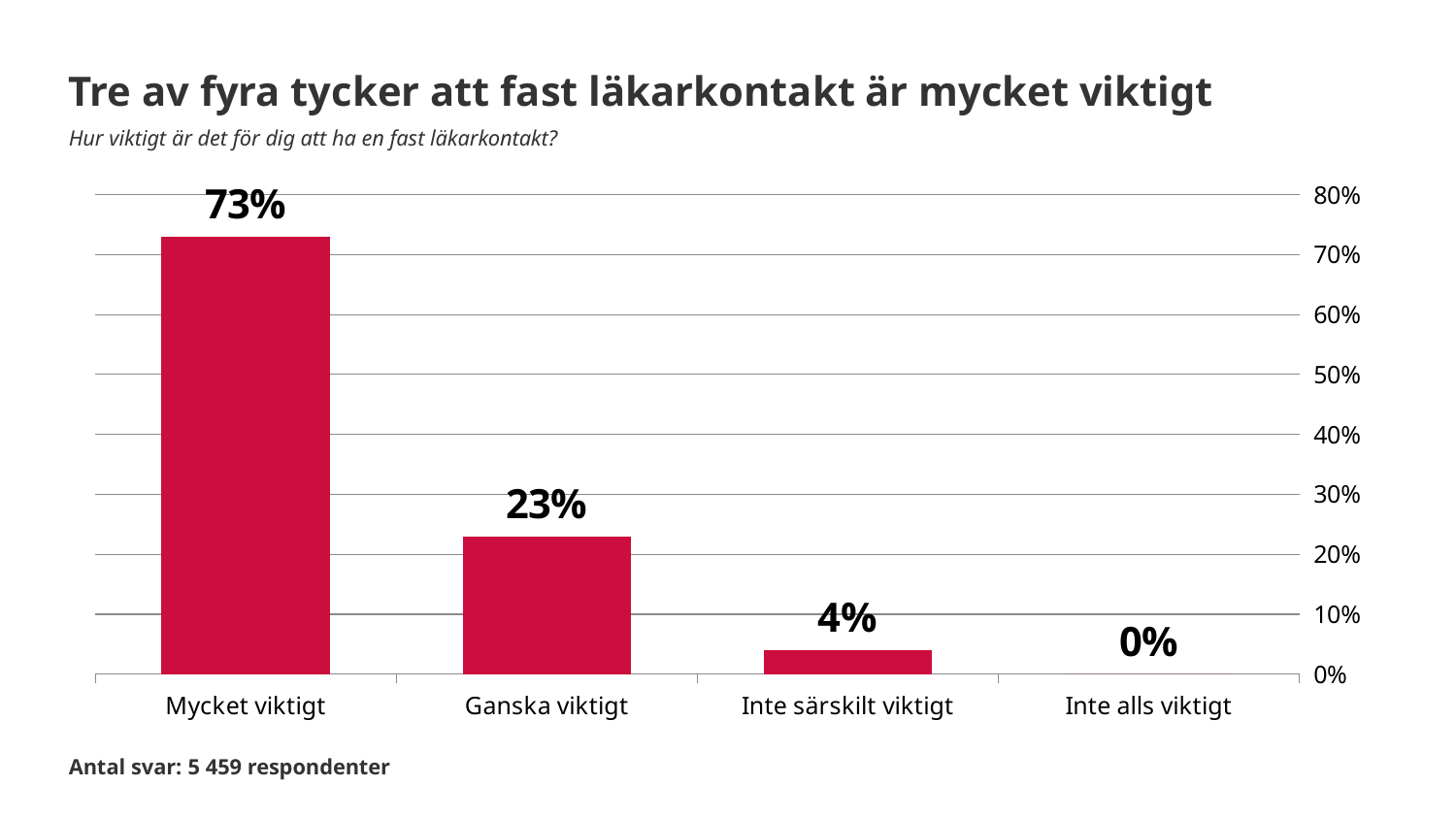
What is the value for "Inte särskilt viktigt"? 4% Do the values rise or fall from left to right along the x axis? Fall Which category has the lowest value? Inte alls viktigt What is the value for "Inte alls viktigt"? 0% What is the value for "Ganska viktigt"? 23% What is the difference between the values for "Mycket viktigt" and "Ganska viktigt"? 50% What is the title of the slide? Tre av fyra tycker att fast läkarkontakt är mycket viktigt What kind of chart is shown on the slide? Bar chart Which category has the highest value? Mycket viktigt What is the value for "Mycket viktigt"? 73% Which is larger, the value for "Ganska viktigt" or the value for "Inte särskilt viktigt"? Ganska viktigt How many categories are shown on the x axis? 4